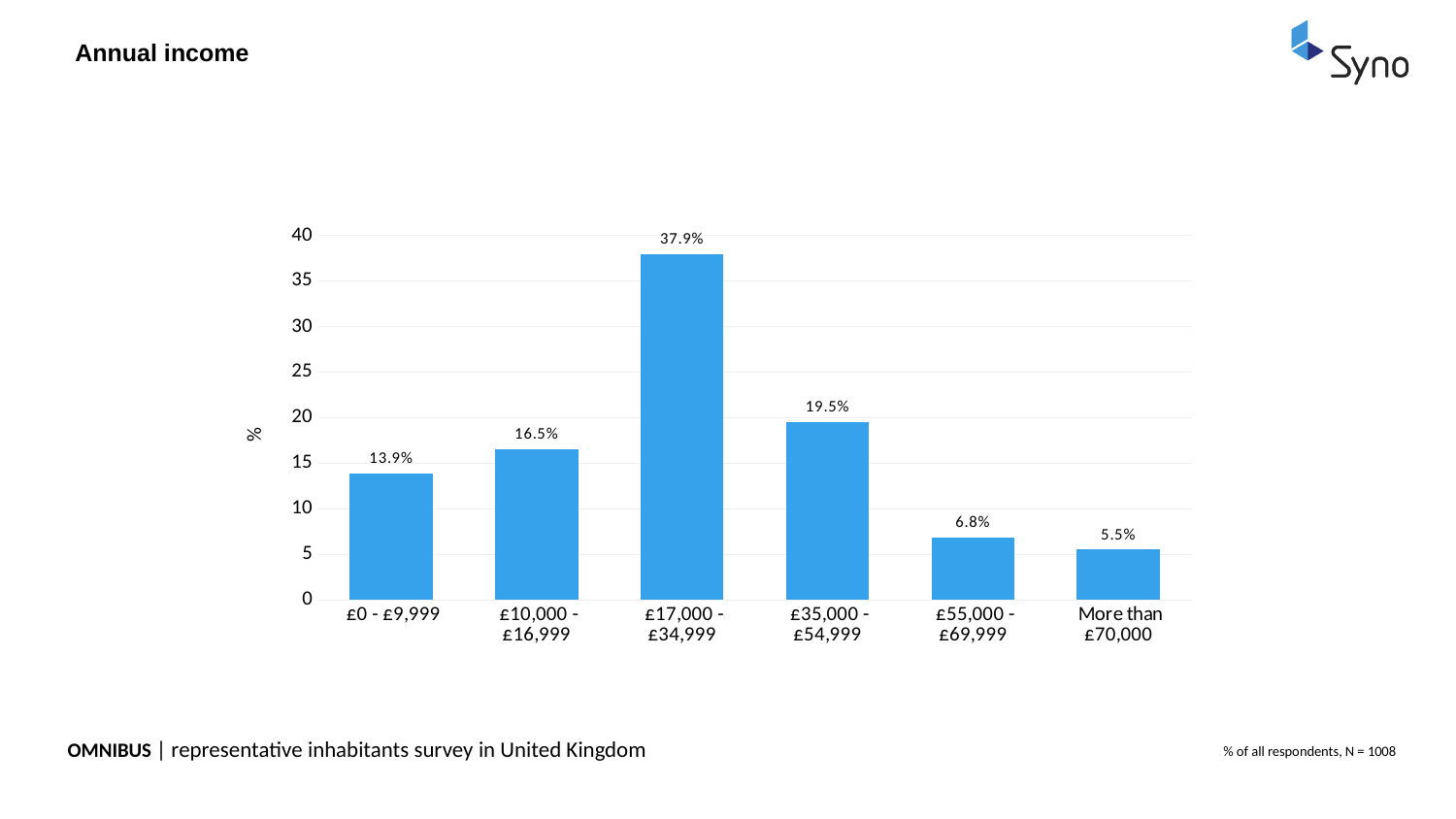
What is the difference between the £35,000 - £54,999 and £55,000 - £69,999 categories? 12.7% Is the value for £55,000 - £69,999 greater or less than 10? less What is the difference between the £17,000 - £34,999 and £35,000 - £54,999 categories? 18.4% Which income category has the lowest percentage of respondents? More than £70,000 How many income categories are shown on the chart? 6 What is the title of the chart on the slide? Annual income Which income category has the highest percentage of respondents? £17,000 - £34,999 Which is larger, the value for £10,000 - £16,999 or the value for £0 - £9,999? £10,000 - £16,999 What percentage of respondents earn more than £70,000? 5.5% What kind of chart is shown on the slide? Bar chart What is the value for the £0 - £9,999 income category? 13.9% What percentage of respondents have an annual income of £17,000 - £34,999? 37.9%